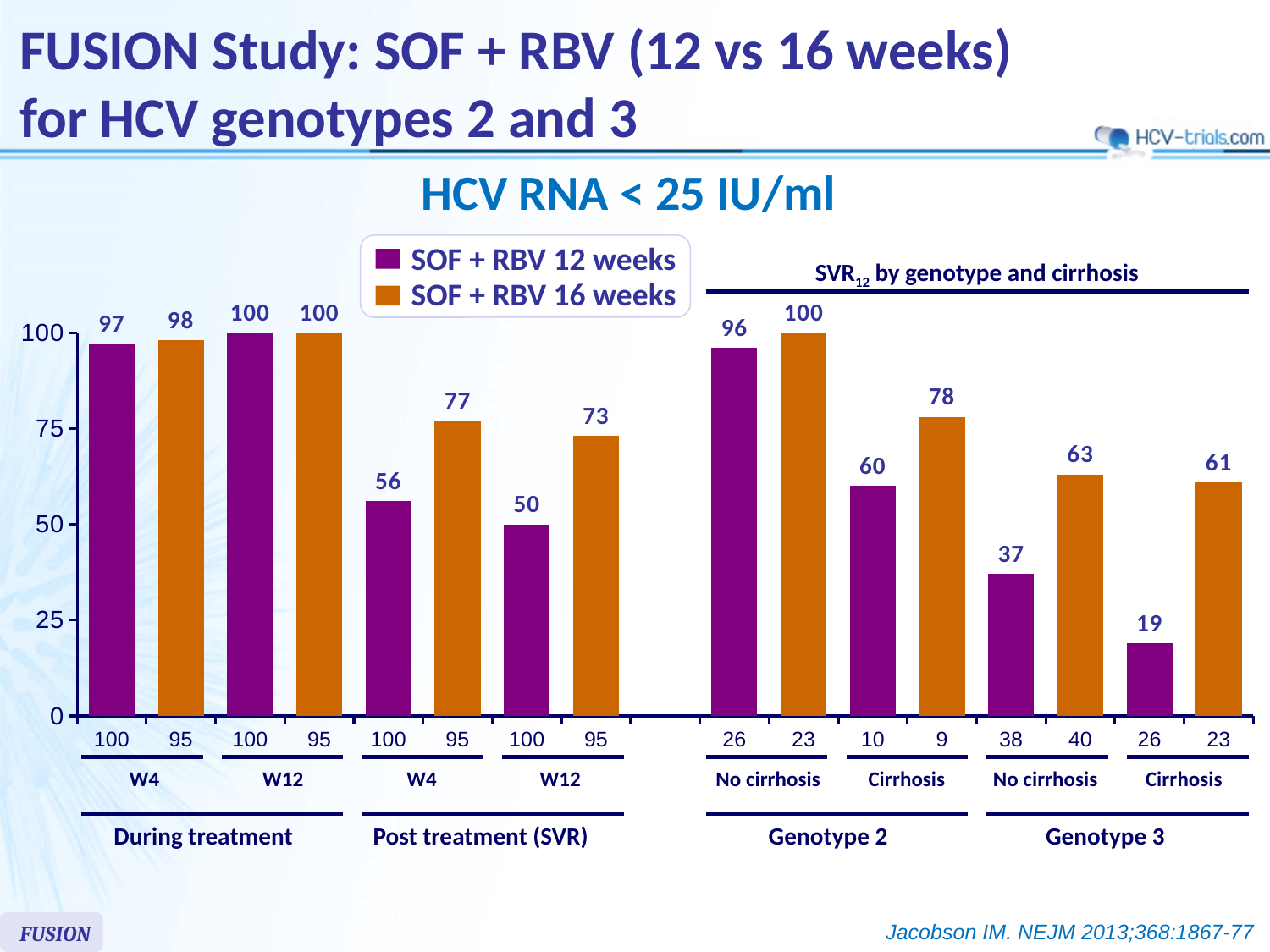
What is the difference between the SOF + RBV 16 weeks and SOF + RBV 12 weeks values at W4 post treatment (SVR)? 21 How many series does the legend list? 2 What is the value for SOF + RBV 16 weeks at W12 post treatment (SVR)? 73 What is the SVR12 value for SOF + RBV 16 weeks in Genotype 2 patients with no cirrhosis? 100 What is the difference between the 16-week and 12-week SVR12 values for Genotype 3 patients with cirrhosis? 42 Which colour represents SOF + RBV 16 weeks in the legend? Orange What is the title of the chart? HCV RNA < 25 IU/ml What is the value for SOF + RBV 12 weeks at W4 during treatment? 97 What is the SVR12 value for SOF + RBV 12 weeks in Genotype 3 patients with cirrhosis? 19 What kind of chart is shown on the slide? Bar chart Which is larger: the SVR12 value for SOF + RBV 12 weeks in Genotype 2 with cirrhosis, or in Genotype 3 with no cirrhosis? Genotype 2 with cirrhosis Which bar has the lowest value on the chart? SOF + RBV 12 weeks, Genotype 3, Cirrhosis